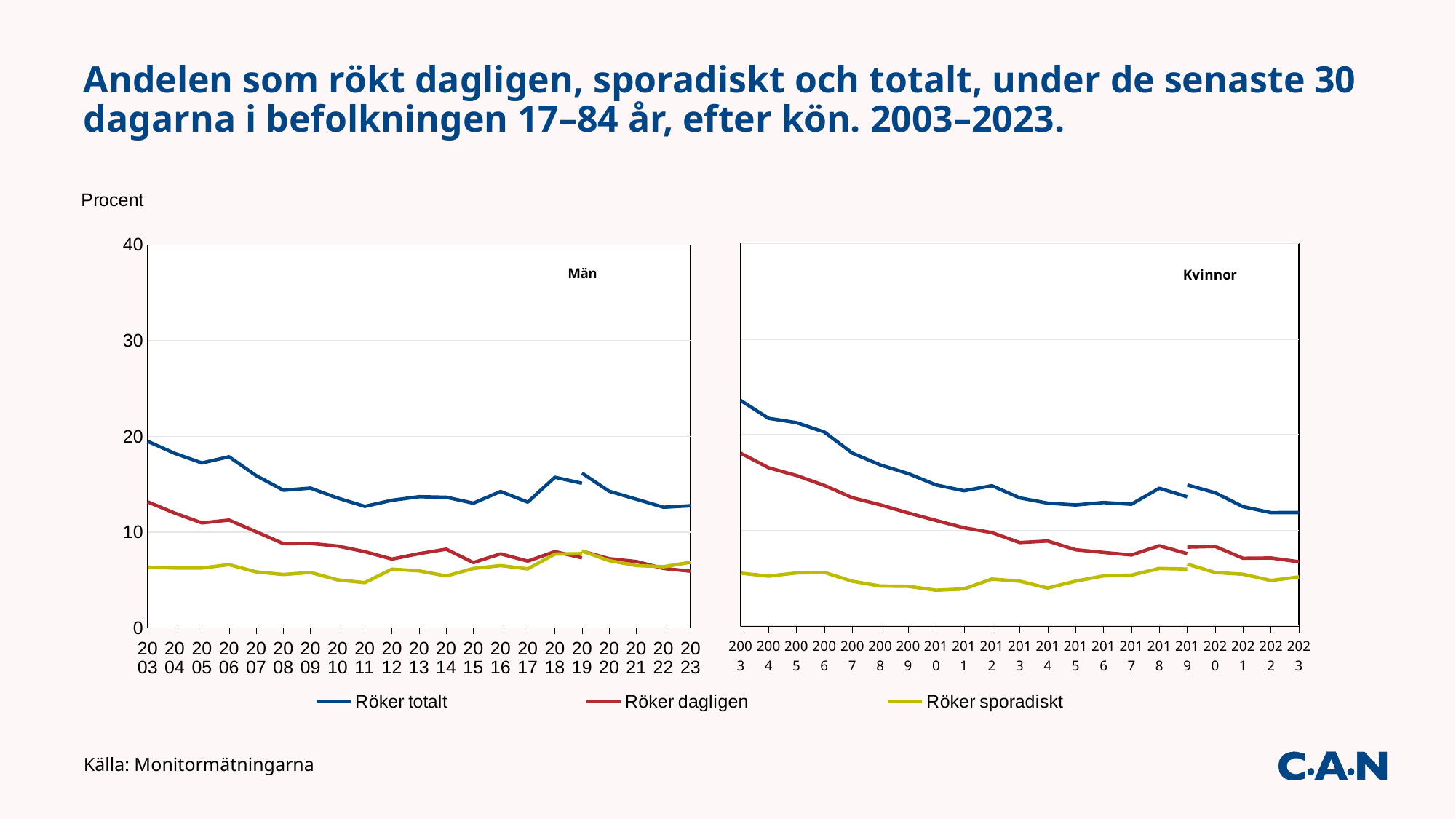
In the Män chart, how many years are shown on the x axis? 21 How many series does the legend list? 3 In the Kvinnor chart, does the Röker dagligen line rise or fall from 2003 to 2023? fall In the Män chart, is the value for Röker dagligen in 2023 greater or less than 10? less In the Kvinnor chart, is the value for Röker totalt in 2003 greater or less than 20? greater In the Kvinnor chart, in which year is Röker totalt highest? 2003 Which is larger in 2003: Röker totalt in the Kvinnor chart or Röker totalt in the Män chart? Kvinnor What colour is the Röker sporadiskt line in the legend? yellow In the Kvinnor chart, is the value for Röker dagligen in 2003 greater or less than 20? less In the Män chart, in which year is Röker totalt highest? 2003 What kind of chart is the left chart labelled Män? line chart In the Män chart, does the Röker totalt line rise or fall from 2003 to 2023? fall